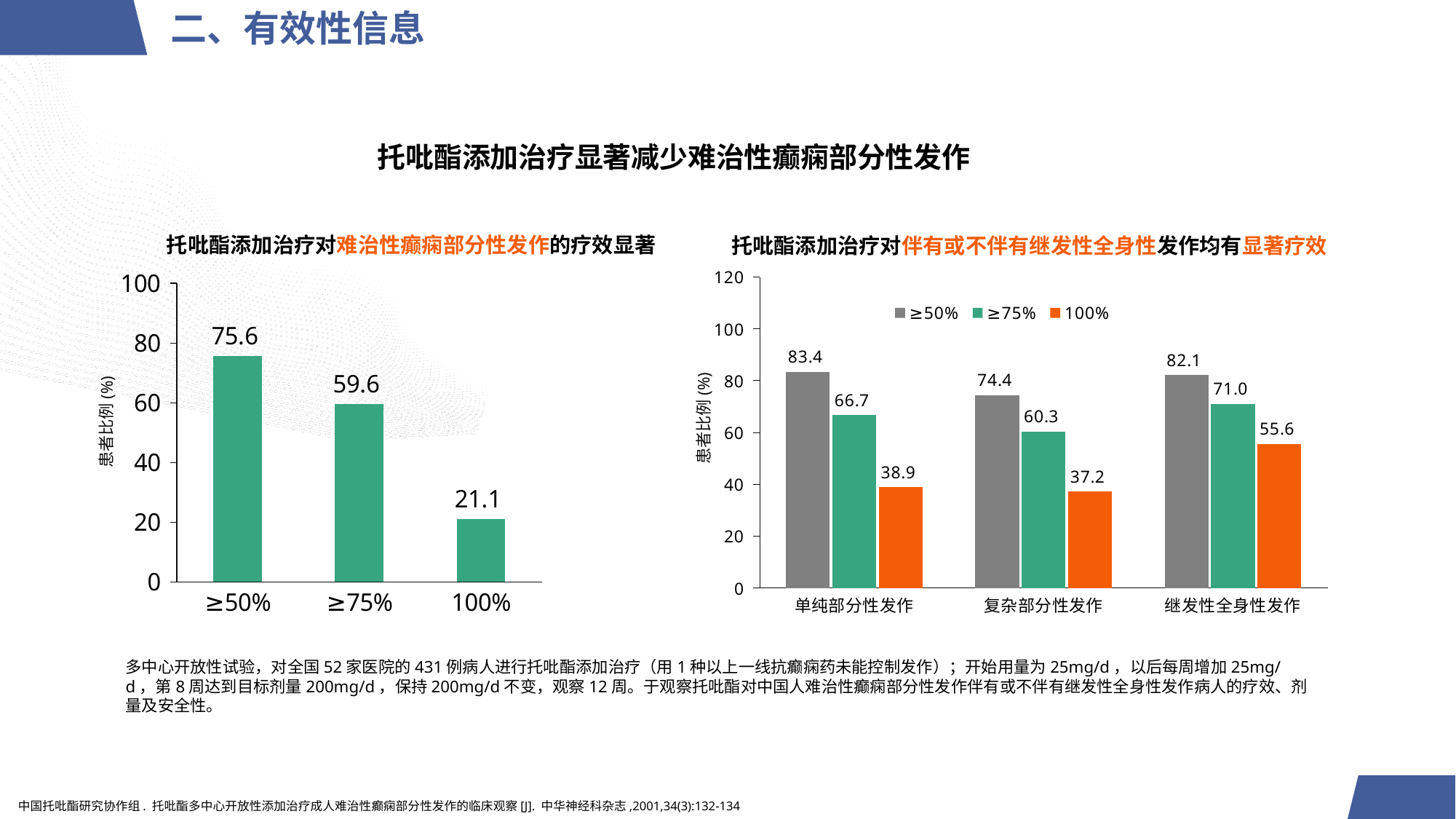
What type of chart is the right chart? bar chart In the left chart, which category has the lowest value? 100% In the left chart, how many categories are shown on the x axis? 3 In the left chart, do the values rise or fall from left to right along the x axis? fall In the right chart, what is the difference between the ≥50% and ≥75% values for 单纯部分性发作? 16.7 In the left chart, what is the difference between the ≥50% and ≥75% values? 16.0 In the right chart, what is the value of the 100% series for 继发性全身性发作? 55.6 In the right chart, what is the value of the ≥75% series for 复杂部分性发作? 60.3 In the left chart, what is the value for the ≥50% category? 75.6 In the right chart, which category has the highest ≥50% value? 单纯部分性发作 How many series does the legend of the right chart list? 3 In the right chart, which is larger: the 100% value for 单纯部分性发作 or the 100% value for 复杂部分性发作? 单纯部分性发作